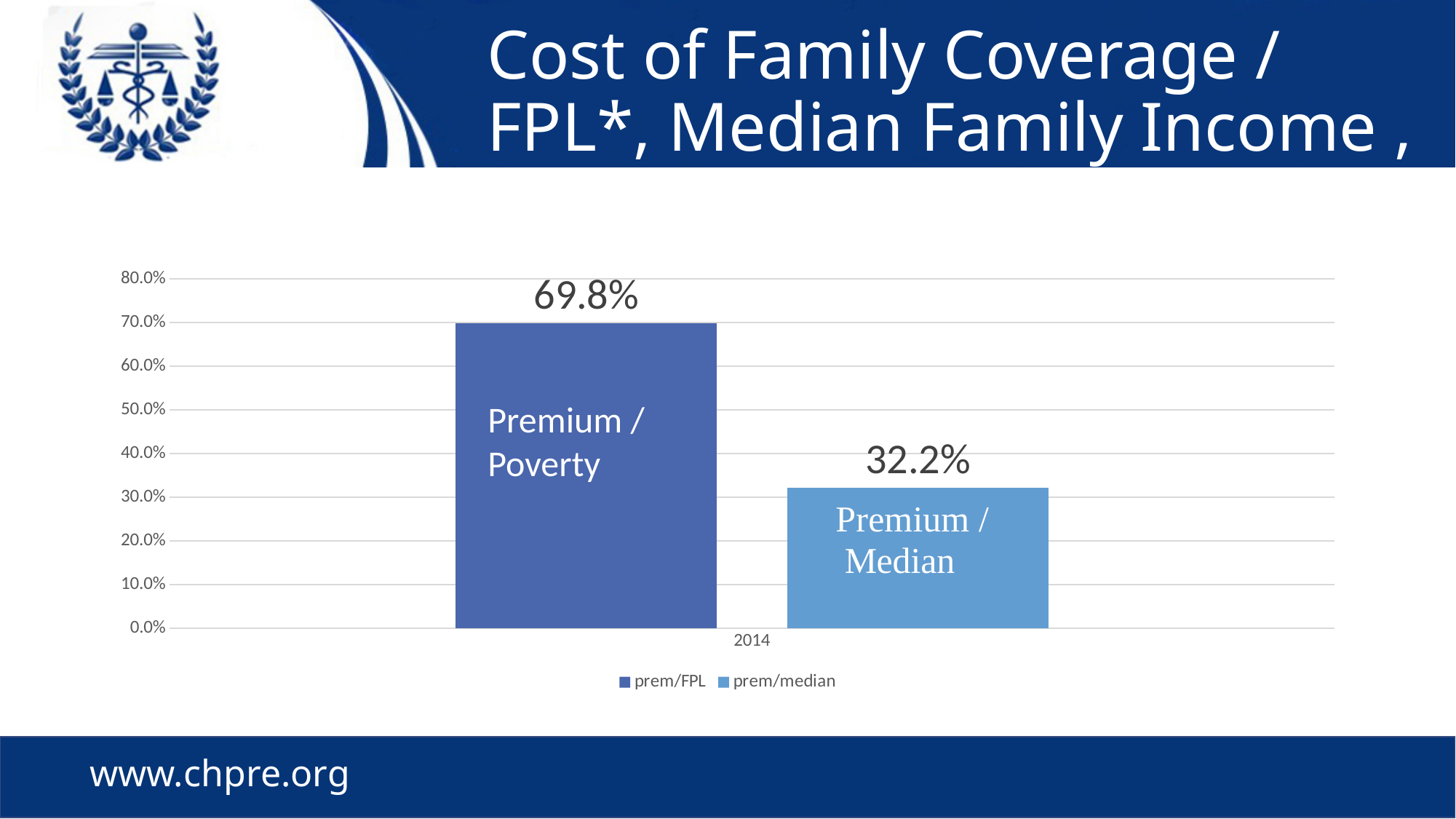
How many categories are shown on the x axis? 1 What kind of chart is shown on the slide? Bar chart Which series has the lowest value on the chart? prem/median What is the value of the prem/FPL series for 2014? 69.8% What year is shown on the x axis of the chart? 2014 Is the value for prem/median greater or less than 40.0%? less How many series does the legend list? 2 What is the difference between the prem/FPL value and the prem/median value? 37.6% What is the value of the prem/median series for 2014? 32.2% Which series has the higher value in 2014, prem/FPL or prem/median? prem/FPL What is the maximum value shown on the y axis? 80.0% Is the value for prem/FPL greater or less than 60.0%? greater